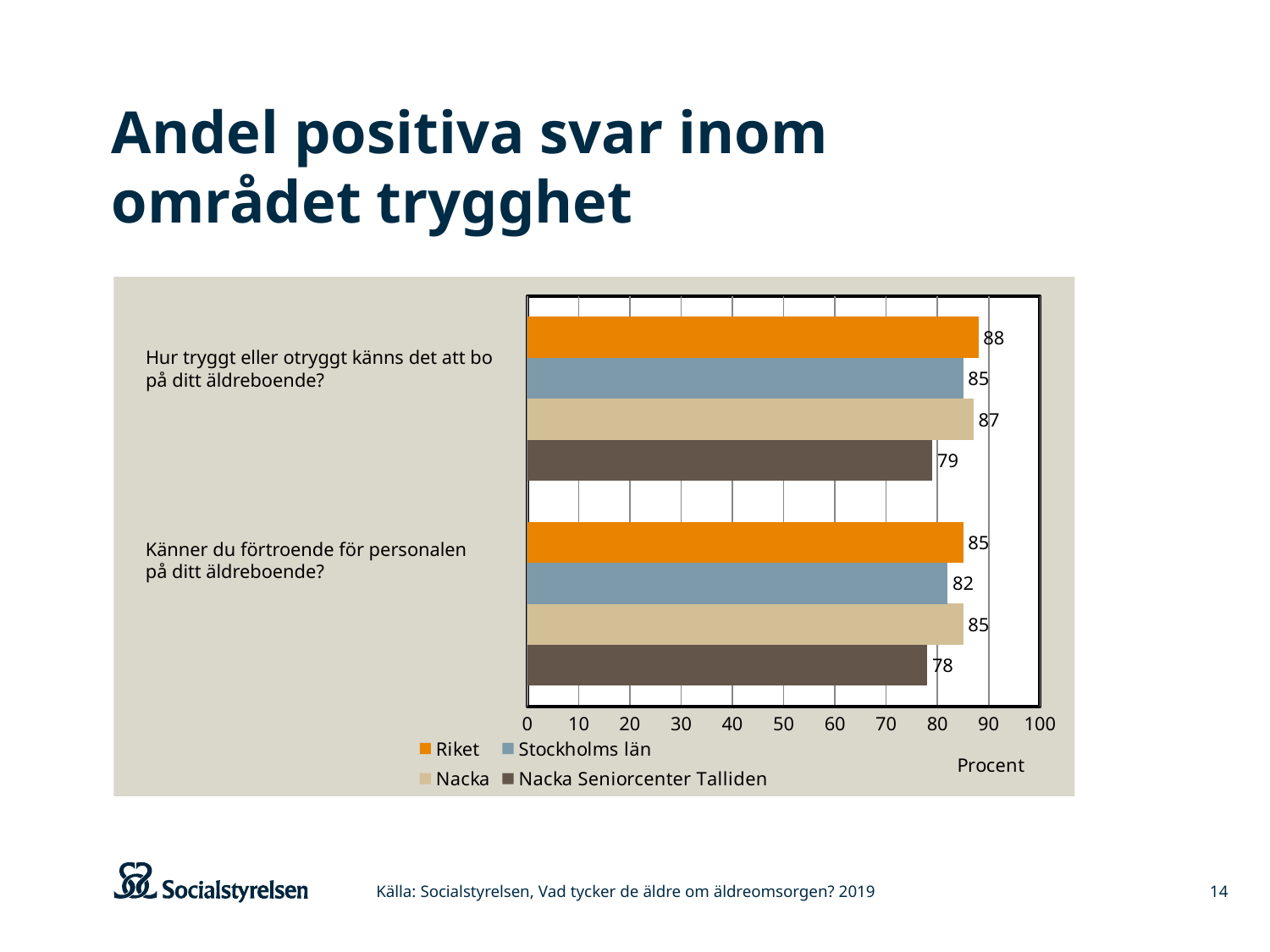
What is the difference between Nacka and Stockholms län on the question "Känner du förtroende för personalen på ditt äldreboende?"? 3 What is the value for Nacka on the question "Hur tryggt eller otryggt känns det att bo på ditt äldreboende?"? 87 Which series has the highest value on the question "Hur tryggt eller otryggt känns det att bo på ditt äldreboende?"? Riket What is the value for Nacka Seniorcenter Talliden on the question "Känner du förtroende för personalen på ditt äldreboende?"? 78 Which series has the lowest value on the question "Hur tryggt eller otryggt känns det att bo på ditt äldreboende?"? Nacka Seniorcenter Talliden What is the label on the horizontal axis of the chart? Procent Which is larger: the value for Stockholms län or for Nacka Seniorcenter Talliden on the question "Känner du förtroende för personalen på ditt äldreboende?"? Stockholms län What is the value for Stockholms län on the question "Känner du förtroende för personalen på ditt äldreboende?"? 82 How many series does the legend list? 4 What kind of chart is shown on the slide? Bar chart What is the value for Riket on the question "Hur tryggt eller otryggt känns det att bo på ditt äldreboende?"? 88 What is the difference between Riket and Nacka Seniorcenter Talliden on the question "Hur tryggt eller otryggt känns det att bo på ditt äldreboende?"? 9